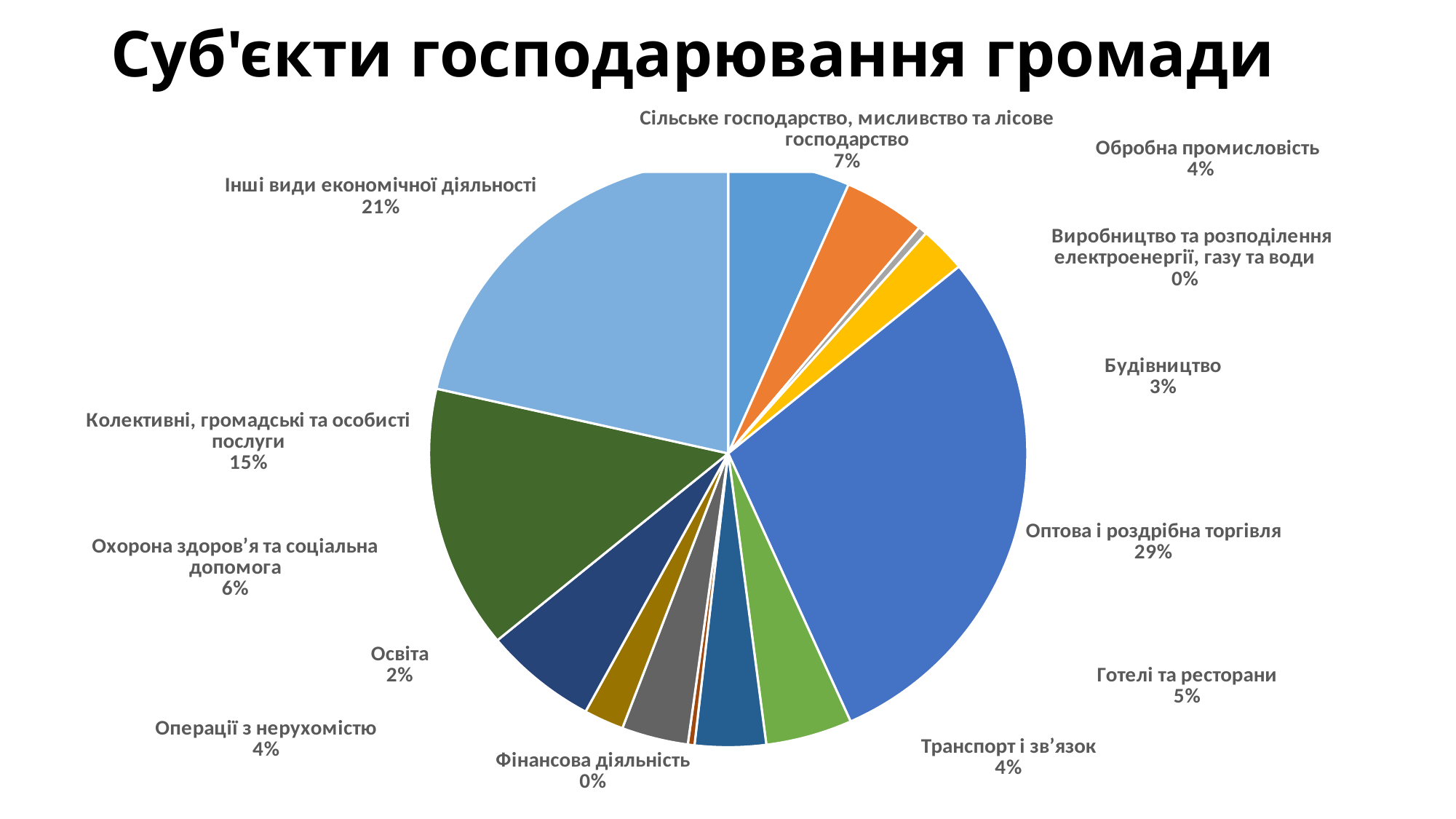
Which category has the largest share of the pie? Оптова і роздрібна торгівля How many categories are shown in the pie chart? 13 What kind of chart is shown on the slide? pie chart What is the value for Готелі та ресторани? 5% What is the difference between the shares of Оптова і роздрібна торгівля and Інші види економічної діяльності? 8% What is the value for Інші види економічної діяльності? 21% Which is larger: Колективні, громадські та особисті послуги or Охорона здоров'я та соціальна допомога? Колективні, громадські та особисті послуги What is the value for Освіта? 2% What is the value for Колективні, громадські та особисті послуги? 15% What share of the pie does Оптова і роздрібна торгівля have? 29% What is the title of the chart? Суб'єкти господарювання громади What is the value for Сільське господарство, мисливство та лісове господарство? 7%